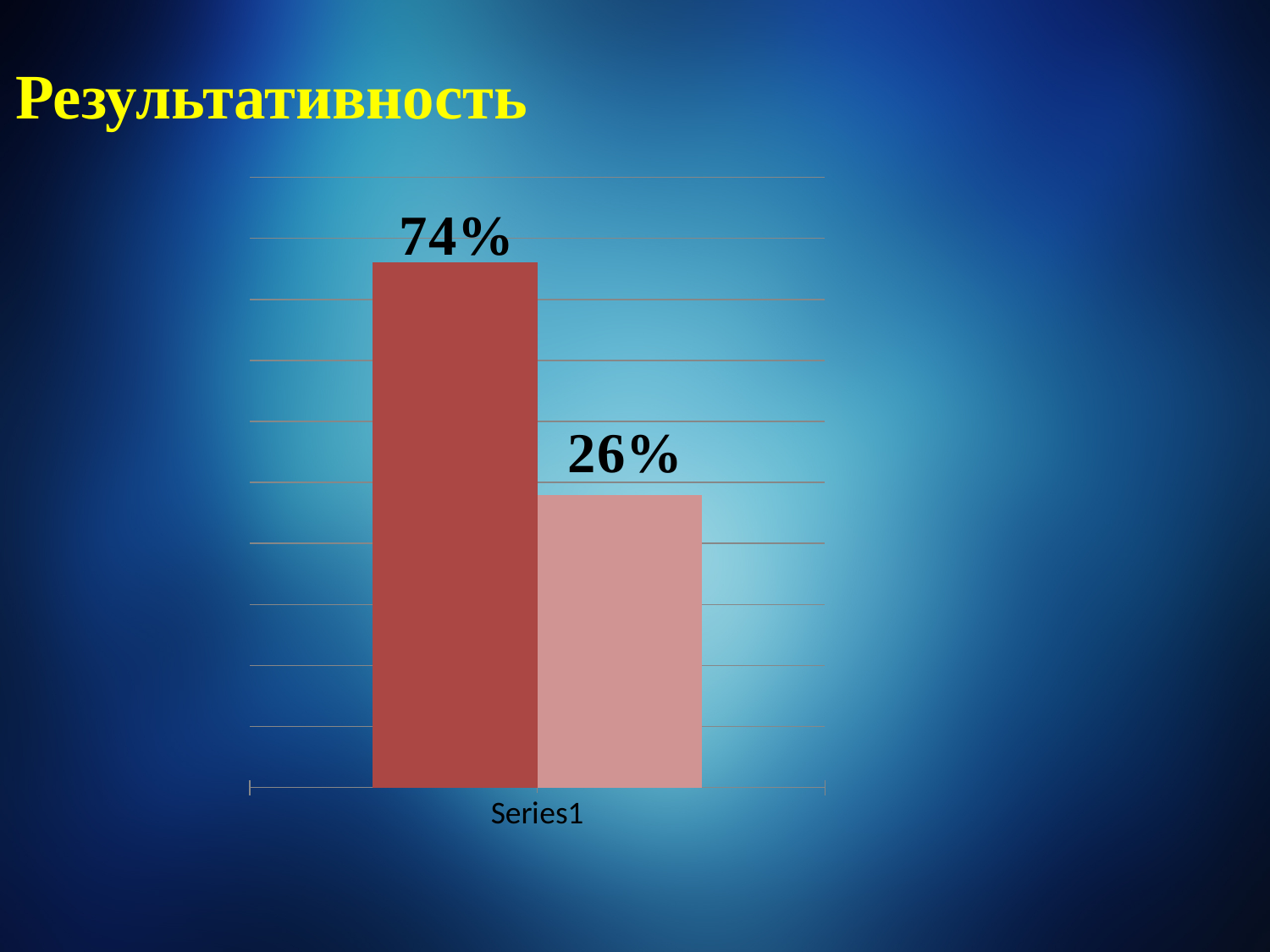
Which bar is taller, the darker red bar or the lighter pink bar? the darker red bar What value is labelled on the darker red bar? 74% How many bars are plotted in the chart? 2 What is the title of the slide containing the chart? Результативность What is the category label shown on the x axis of the chart? Series1 What is the lowest value shown in the chart? 26% By how many percentage points does the darker red bar exceed the lighter pink bar? 48 What kind of chart is shown on the slide? bar chart What is the highest value shown in the chart? 74% What value is labelled on the lighter pink bar? 26%